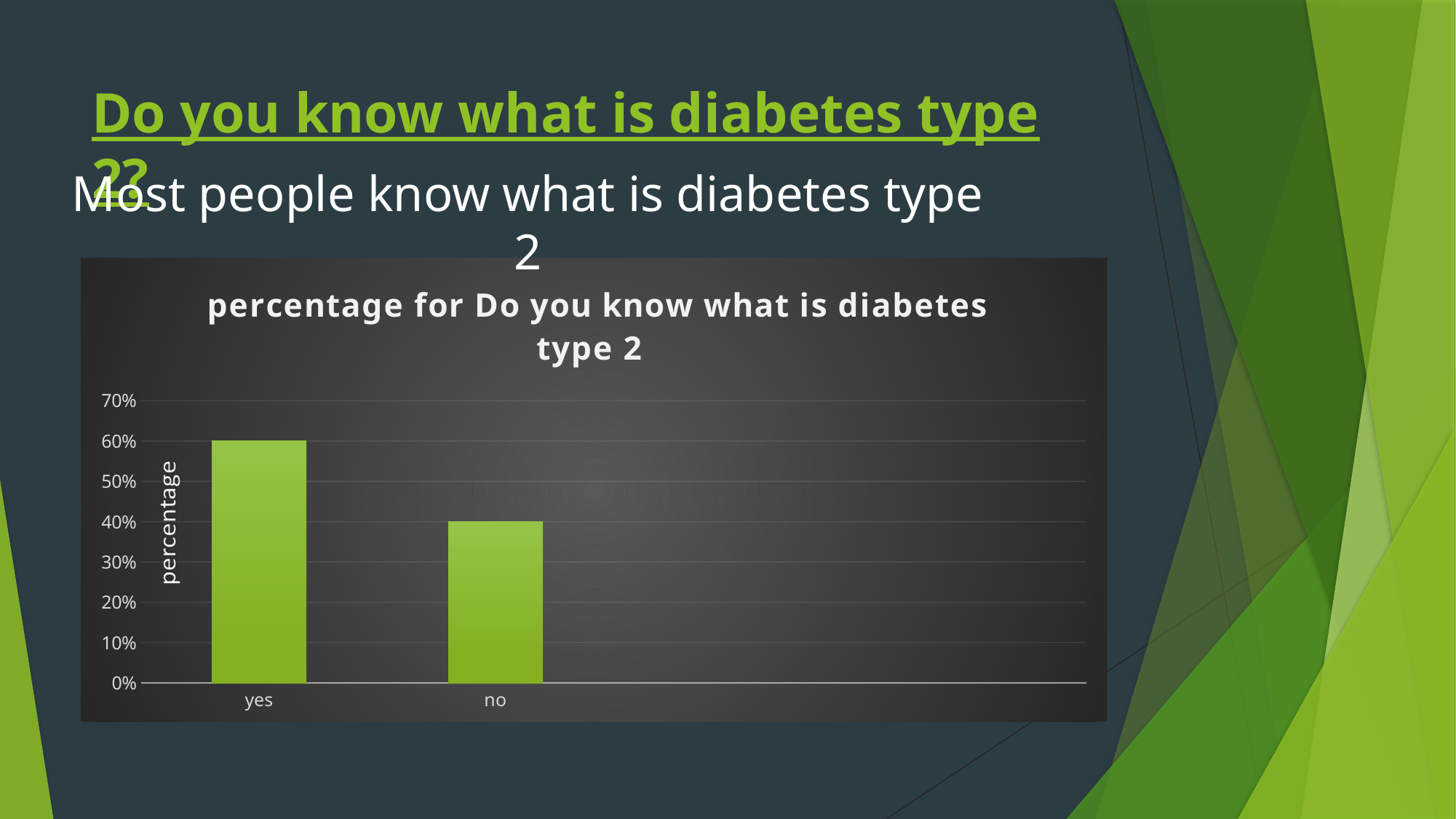
What is the label of the vertical axis? percentage What is the title of the chart? percentage for Do you know what is diabetes type 2 What is the difference between the values for "yes" and "no"? 20% Is the value for "yes" greater or less than 50%? greater Is the value for "no" greater or less than 50%? less Which category has the lowest value? no How many categories are shown on the x axis? 2 Which category has the highest value? yes What is the value for "no"? 40% Which is larger, the value for "yes" or the value for "no"? yes What is the value for "yes"? 60% What kind of chart is shown on the slide? bar chart